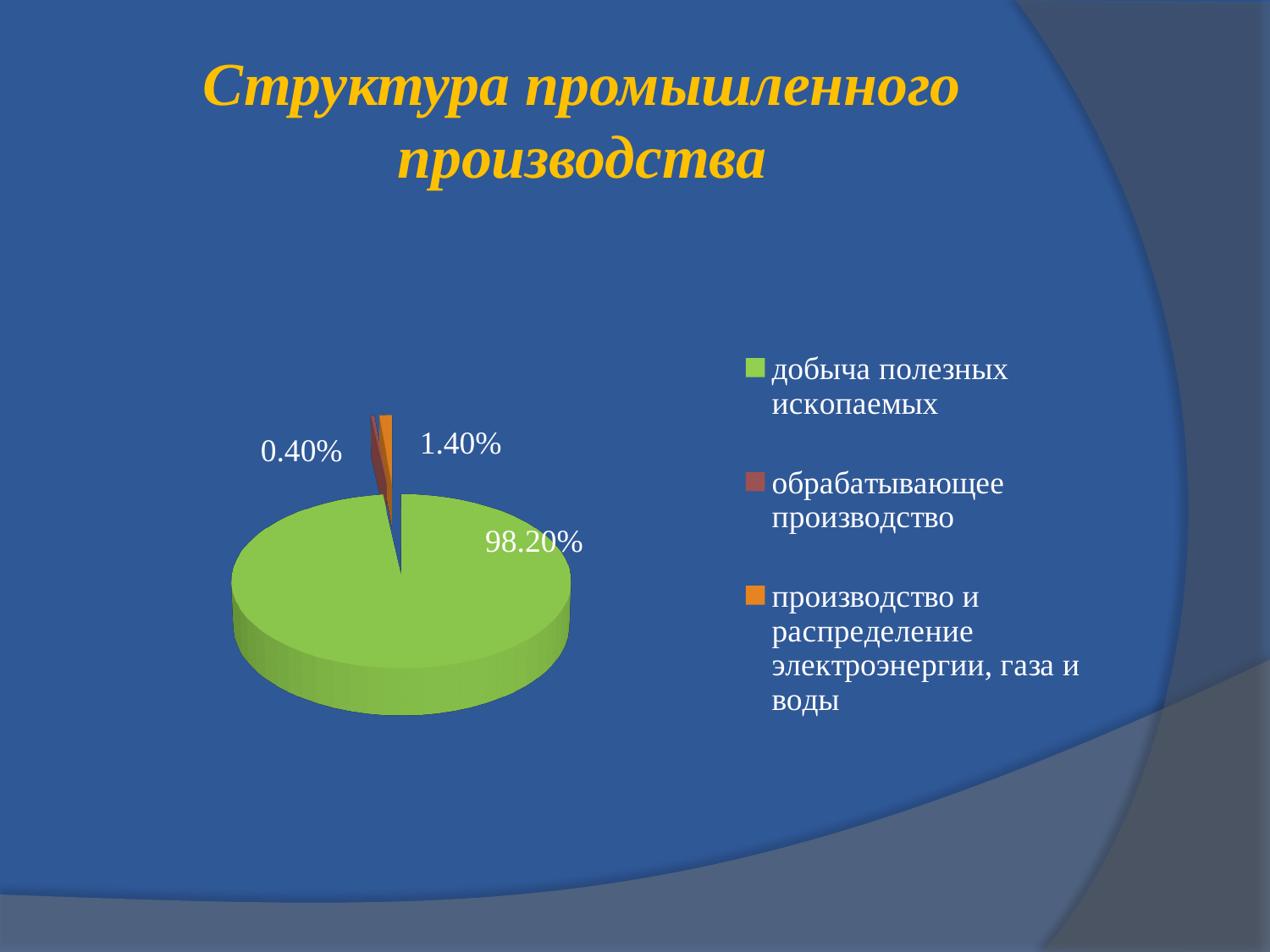
How many categories does the legend of the pie chart list? 3 What kind of chart is shown on the slide? pie chart Which is larger: the share of 'обрабатывающее производство' or the share of 'производство и распределение электроэнергии, газа и воды'? производство и распределение электроэнергии, газа и воды What share of the pie does 'производство и распределение электроэнергии, газа и воды' have? 1.40% What colour is the slice for 'добыча полезных ископаемых'? green Which category has the smallest slice of the pie? обрабатывающее производство What is the difference between the share of 'производство и распределение электроэнергии, газа и воды' and the share of 'обрабатывающее производство'? 1.00% What is the title of the slide with the chart? Структура промышленного производства What is the difference between the share of 'добыча полезных ископаемых' and the share of 'производство и распределение электроэнергии, газа и воды'? 96.80% What share of the pie does 'добыча полезных ископаемых' have? 98.20% Which category has the largest slice of the pie? добыча полезных ископаемых What share of the pie does 'обрабатывающее производство' have? 0.40%